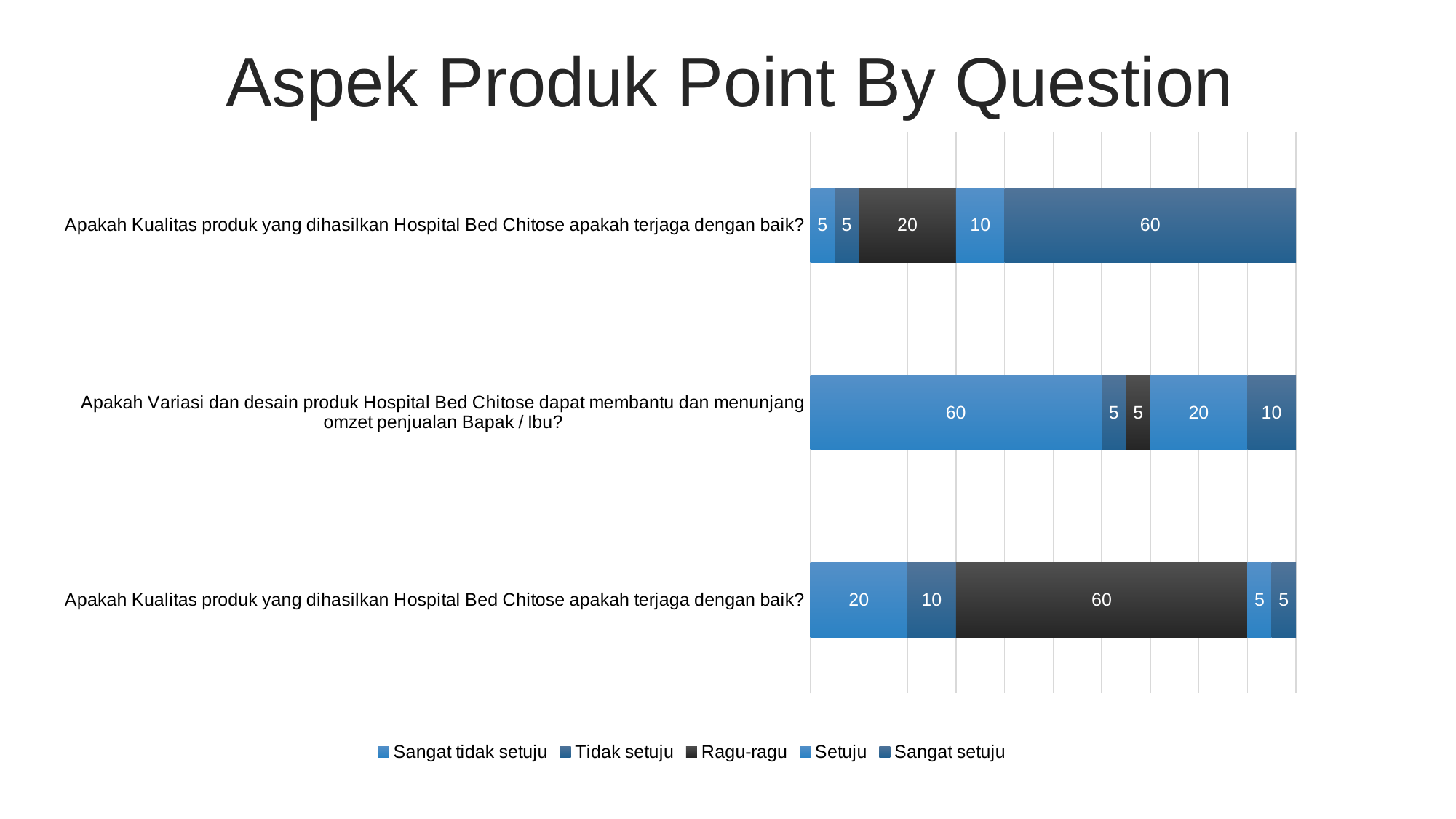
What is the Ragu-ragu value for the middle bar, 'Apakah Variasi dan desain produk Hospital Bed Chitose dapat membantu dan menunjang omzet penjualan Bapak / Ibu?'? 5 What kind of chart is shown on the slide? Stacked bar chart How many series does the legend list? 5 How many bars (questions) are plotted in the chart? 3 What is the Ragu-ragu value for the bottom bar of the chart? 60 Which series has the largest segment in the bottom bar of the chart? Ragu-ragu What is the Sangat tidak setuju value for the middle bar, 'Apakah Variasi dan desain produk Hospital Bed Chitose...'? 60 In the bottom bar, is the Sangat tidak setuju segment larger or smaller than the Tidak setuju segment? Larger What is the title of the chart on the slide? Aspek Produk Point By Question What is the Sangat setuju value for the top bar of the chart? 60 In the middle bar, 'Apakah Variasi dan desain produk Hospital Bed Chitose...', what is the difference between the Setuju value and the Sangat setuju value? 10 What is the total of the stacked segments in the top bar of the chart? 100